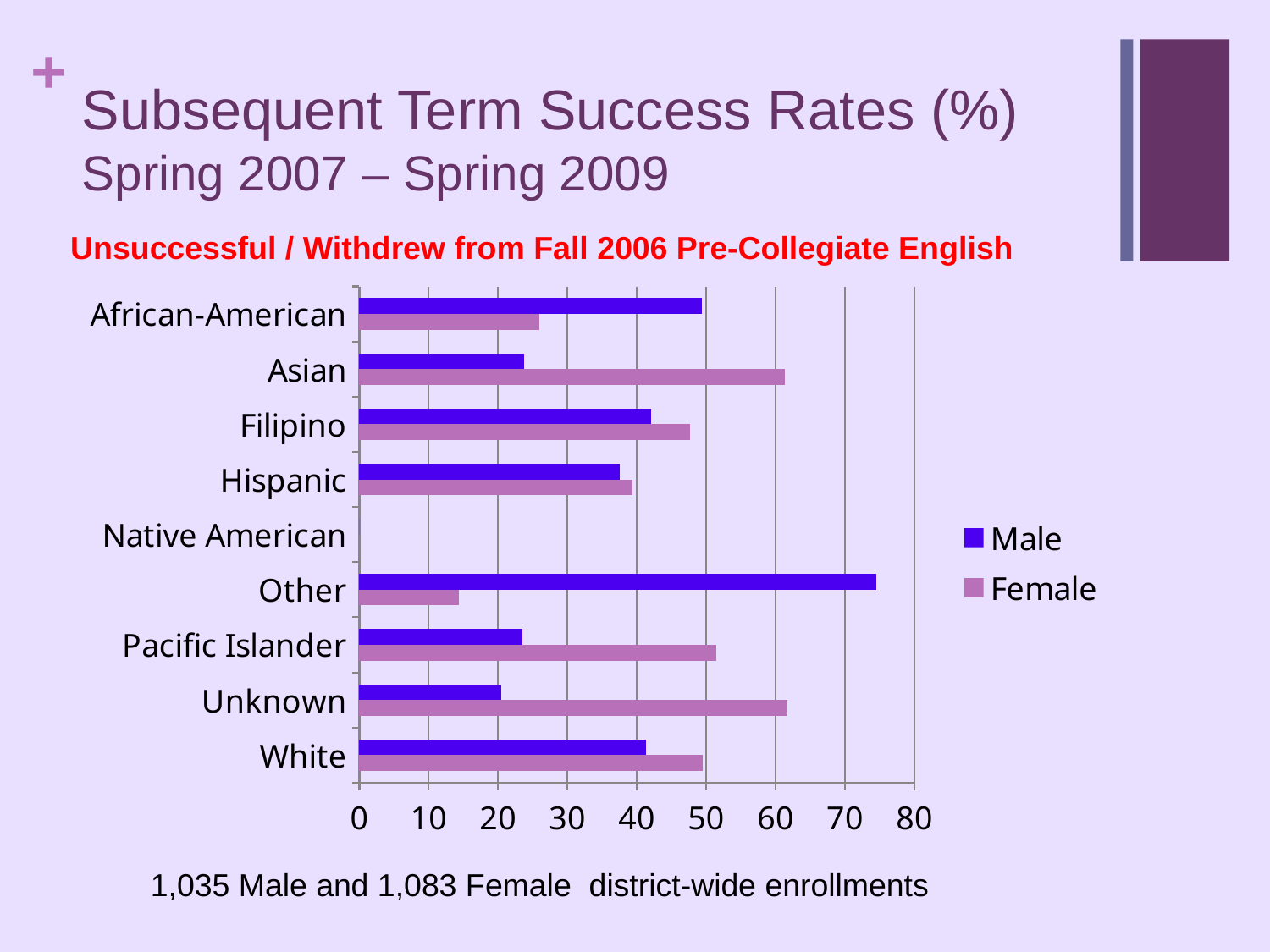
Is the Male value for Unknown greater or less than 30? less How many ethnic categories are listed on the vertical axis of the chart? 9 What kind of chart is shown on the slide? bar chart Which series is shown in the lighter purple colour in the legend? Female Is the Female value for African-American greater or less than 30? less How many series does the legend list? 2 Is the Male value for Other greater or less than 70? greater For African-American, which is larger, the Male or the Female value? Male For Asian, which is larger, the Male or the Female value? Female Which category has the highest Male success rate? Other